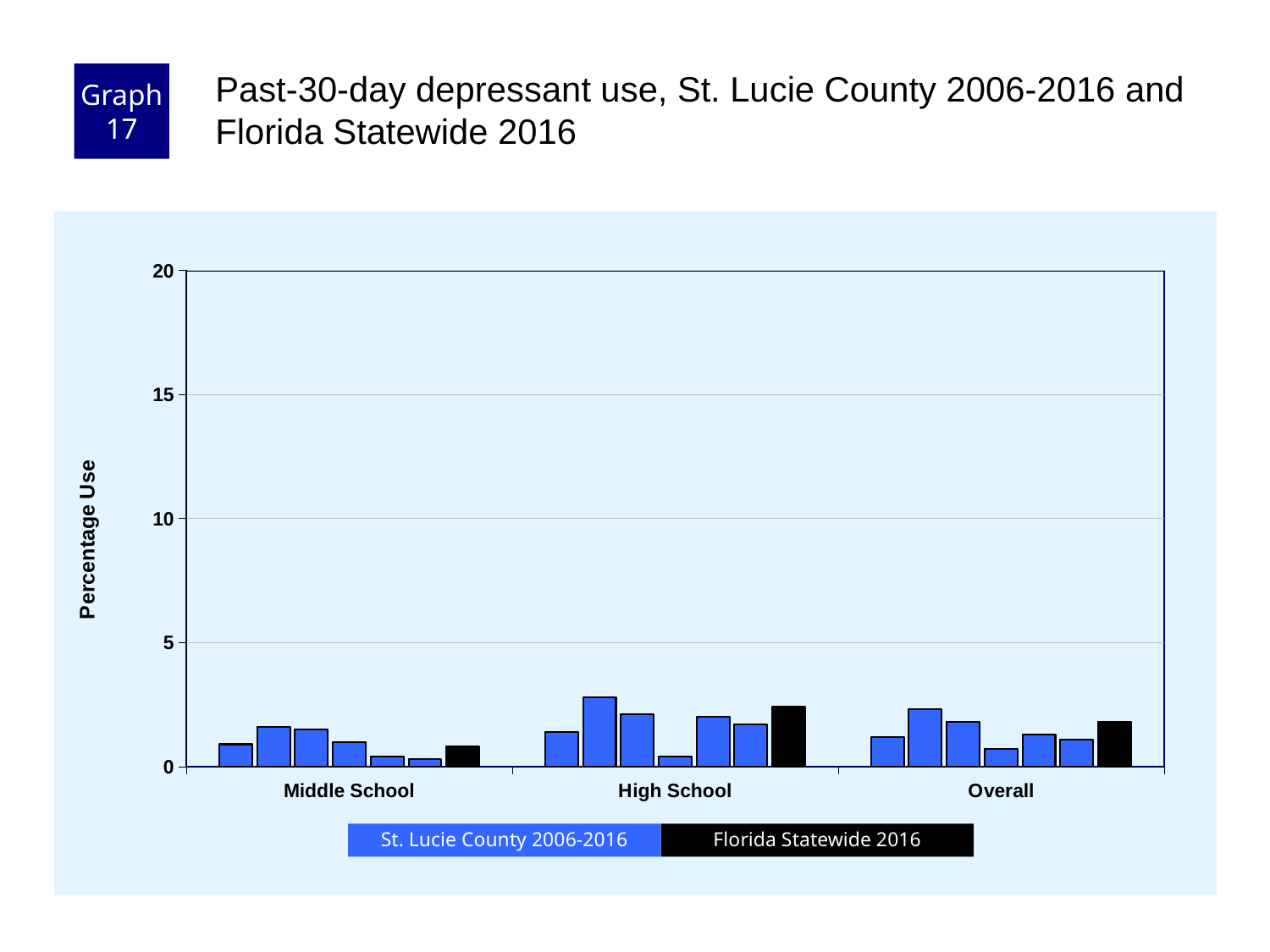
Which category has the lowest Florida Statewide 2016 bar? Middle School Which colour represents Florida Statewide 2016 in the legend? black Which is larger, the Florida Statewide 2016 bar for Overall or for Middle School? Overall What is the label on the y axis? Percentage Use Which is larger, the Florida Statewide 2016 bar for High School or for Middle School? High School How many series does the legend list? 2 How many categories are shown along the x axis? 3 What kind of chart is shown on the slide? bar chart Is the Florida Statewide 2016 value for Middle School greater or less than 5? less In which category does the tallest St. Lucie County 2006-2016 bar appear? High School Is the Florida Statewide 2016 value for High School greater or less than 5? less Which category has the highest Florida Statewide 2016 bar? High School